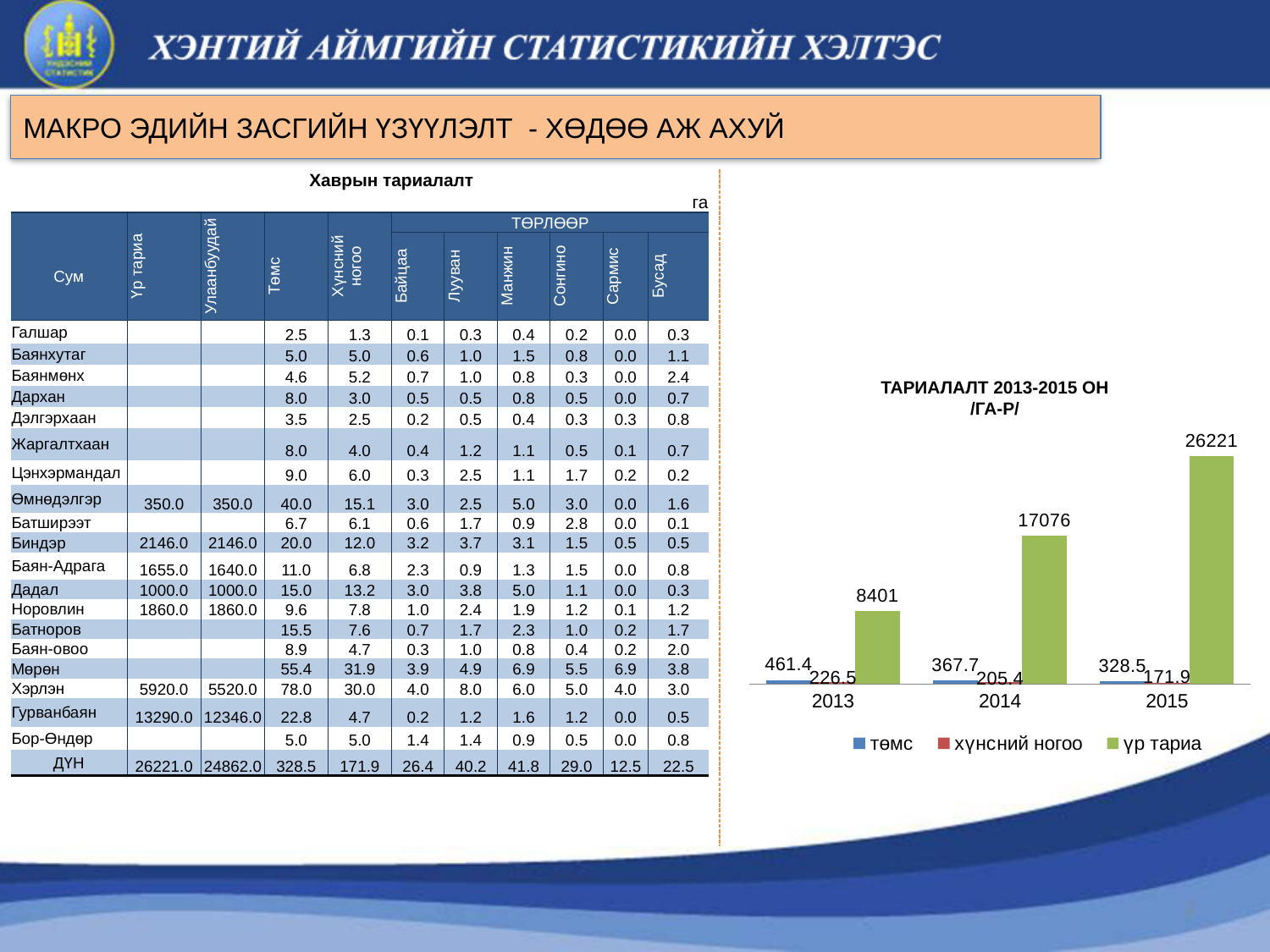
In the chart 'ТАРИАЛАЛТ 2013-2015 ОН /ГА-Р/', which year has the highest value for үр тариа? 2015 What is the value for үр тариа in 2013 in the chart 'ТАРИАЛАЛТ 2013-2015 ОН /ГА-Р/'? 8401 What kind of chart is 'ТАРИАЛАЛТ 2013-2015 ОН /ГА-Р/'? bar chart In the chart 'ТАРИАЛАЛТ 2013-2015 ОН /ГА-Р/', which is larger: төмс in 2013 or төмс in 2014? төмс in 2013 How many series does the legend of the chart 'ТАРИАЛАЛТ 2013-2015 ОН /ГА-Р/' list? 3 What is the value for үр тариа in 2015 in the chart 'ТАРИАЛАЛТ 2013-2015 ОН /ГА-Р/'? 26221 What is the value for хүнсний ногоо in 2014 in the chart 'ТАРИАЛАЛТ 2013-2015 ОН /ГА-Р/'? 205.4 How many years are shown on the x axis of the chart 'ТАРИАЛАЛТ 2013-2015 ОН /ГА-Р/'? 3 In the chart 'ТАРИАЛАЛТ 2013-2015 ОН /ГА-Р/', do the values for хүнсний ногоо rise or fall from 2013 to 2015? fall What is the value for төмс in 2013 in the chart 'ТАРИАЛАЛТ 2013-2015 ОН /ГА-Р/'? 461.4 In the chart 'ТАРИАЛАЛТ 2013-2015 ОН /ГА-Р/', which year has the lowest value for төмс? 2015 In the chart 'ТАРИАЛАЛТ 2013-2015 ОН /ГА-Р/', what is the difference between the үр тариа values for 2015 and 2014? 9145